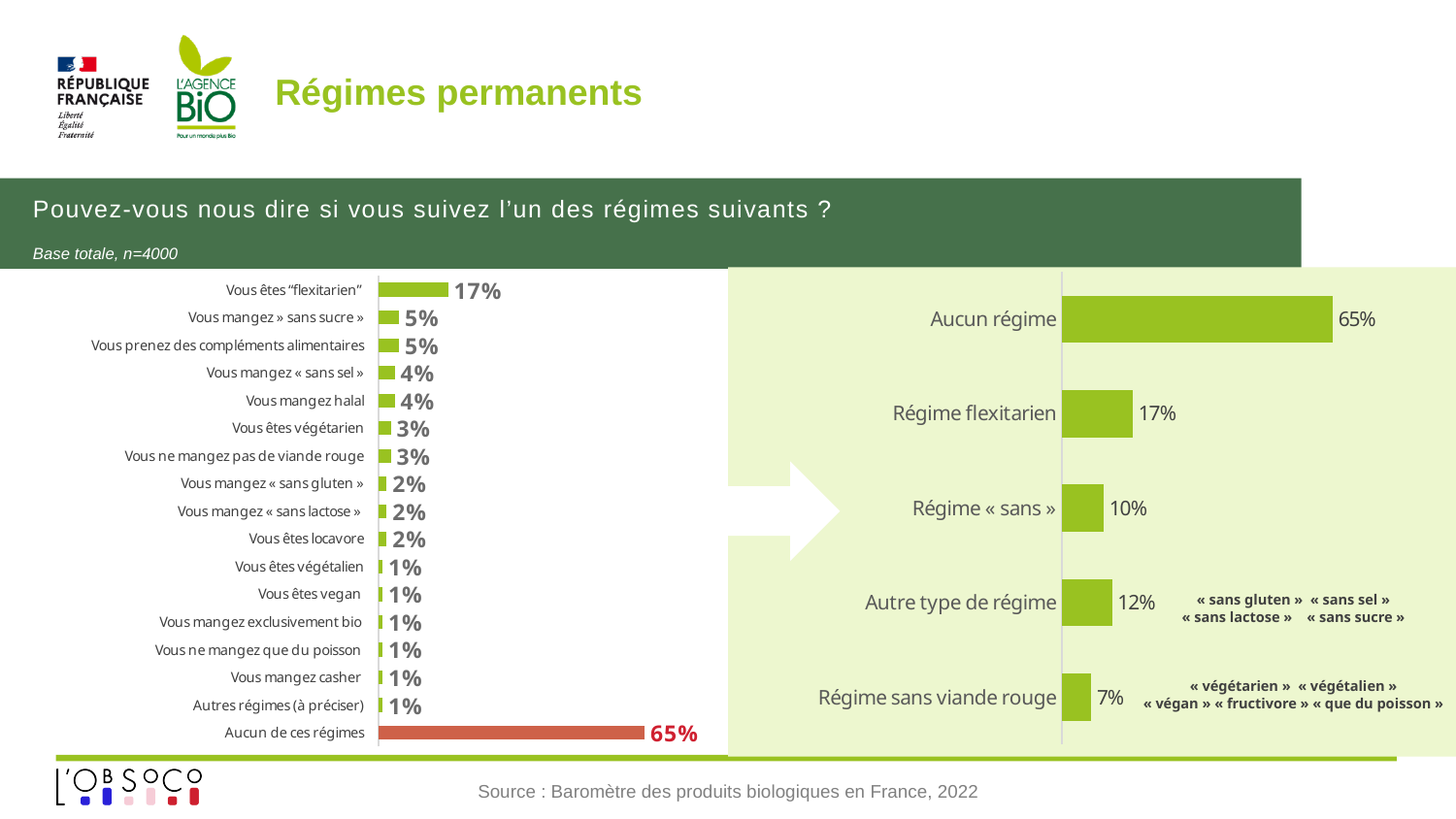
In the left chart, what is the difference between "Vous êtes flexitarien" and "Vous mangez » sans sucre »"? 12 percentage points In the left chart, what is the value for "Vous êtes flexitarien"? 17% In the right chart, which category has the lowest value? Régime sans viande rouge In the right chart, what is the value for "Régime « sans »"? 10% What type of chart is the left chart? Bar chart In the right chart, which category has the highest value? Aucun régime How many categories are shown in the left chart? 17 In the left chart, what is the value for "Vous mangez halal"? 4% In the right chart, which is larger: "Autre type de régime" or "Régime « sans »"? Autre type de régime How many categories are shown in the right chart? 5 In the left chart, what is the value for "Aucun de ces régimes"? 65% In the right chart, what is the difference between "Aucun régime" and "Régime flexitarien"? 48 percentage points